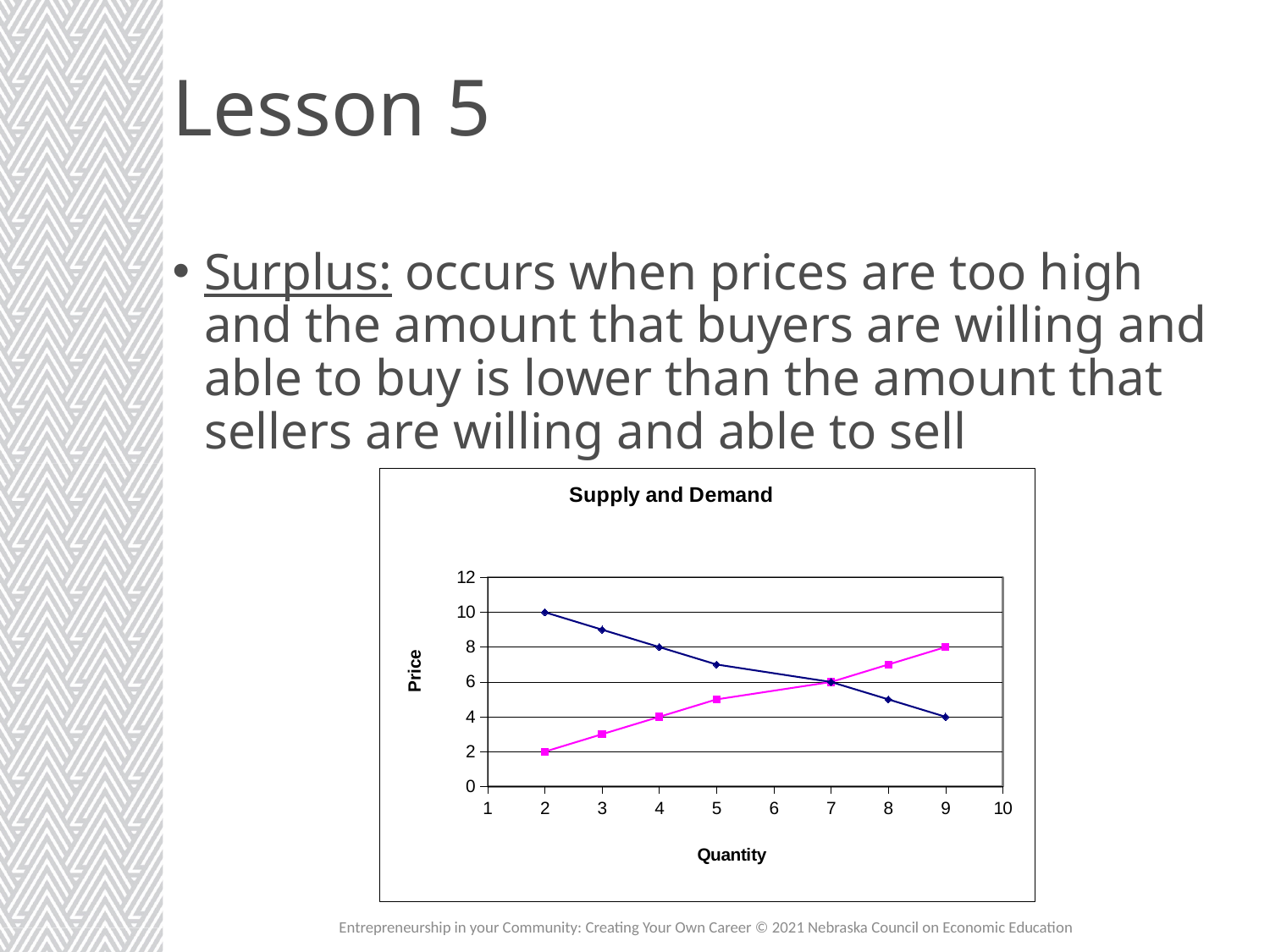
At quantity 3, which line has the higher price, the dark blue line or the pink line? dark blue line What is the difference between the dark blue line and the pink line at quantity 2? 8 What is the price on the pink line at quantity 9? 8 What is the highest price reached by the dark blue line? 10 At what price do the dark blue and pink lines cross at quantity 7? 6 What kind of chart is shown on the slide? line chart Does the dark blue line rise or fall as quantity increases? falls What is the title of the chart? Supply and Demand What is the label on the vertical axis of the chart? Price Does the pink line rise or fall as quantity increases? rises At quantity 8, which line has the higher price, the dark blue line or the pink line? pink line What is the price on the dark blue line at quantity 2? 10